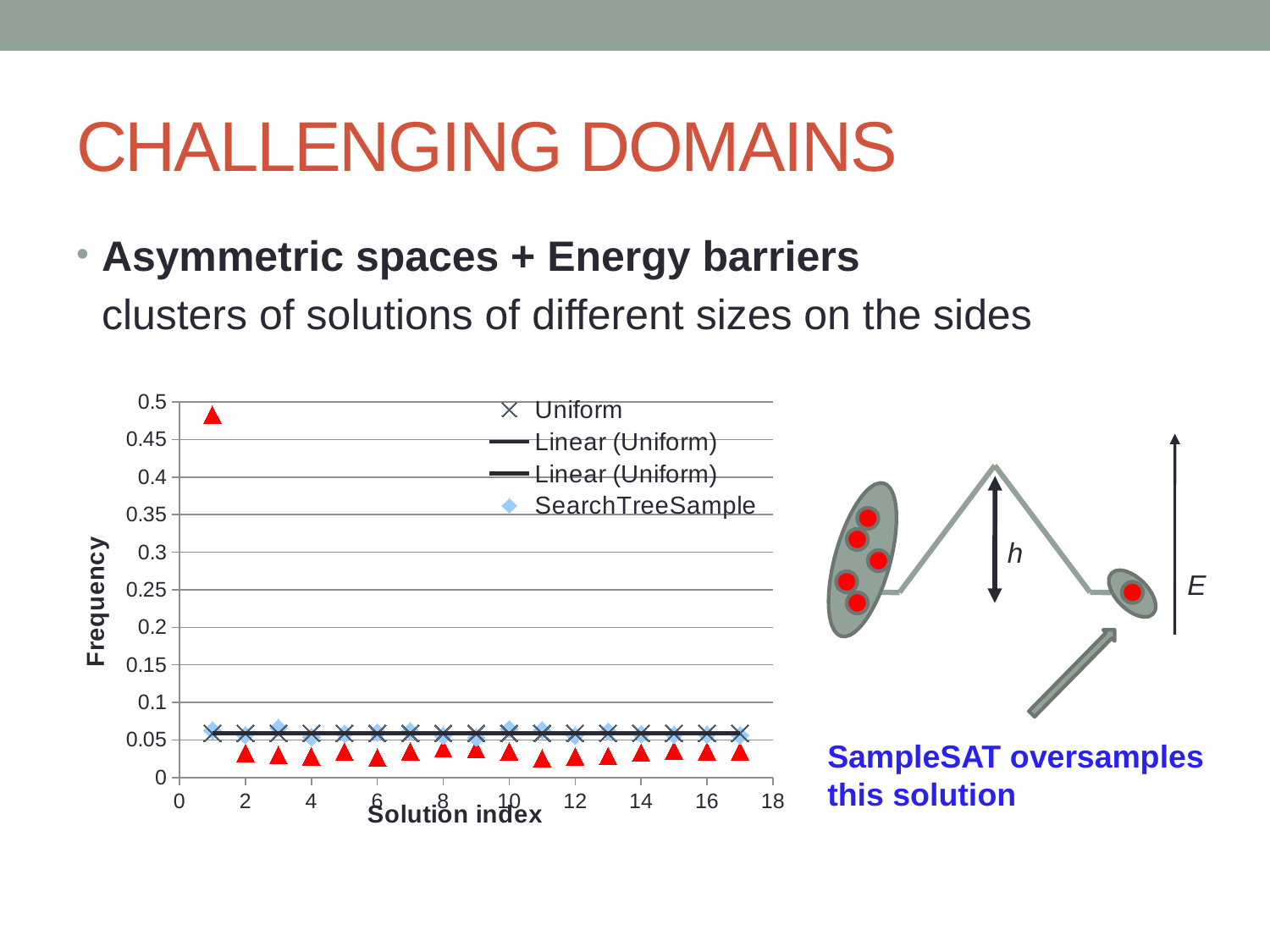
How many entries does the chart's legend list? 4 What kind of chart is shown on the slide? scatter chart How many solution indices have points plotted for the Uniform series? 17 Does the red triangle series rise or fall from solution index 1 to solution index 2? fall Is the value of the Uniform series at solution index 10 greater or less than 0.1? less What is the title of the chart's horizontal axis? Solution index At solution index 1, which is larger: the red triangle value or the Uniform value? the red triangle value At which solution index does the red triangle series reach its highest value? 1 Is the value of the red triangle point at solution index 1 greater or less than 0.45? greater What is the title of the chart's vertical axis? Frequency Is the value of the red triangle point at solution index 2 greater or less than 0.05? less What is the highest value shown on the chart's vertical axis? 0.5